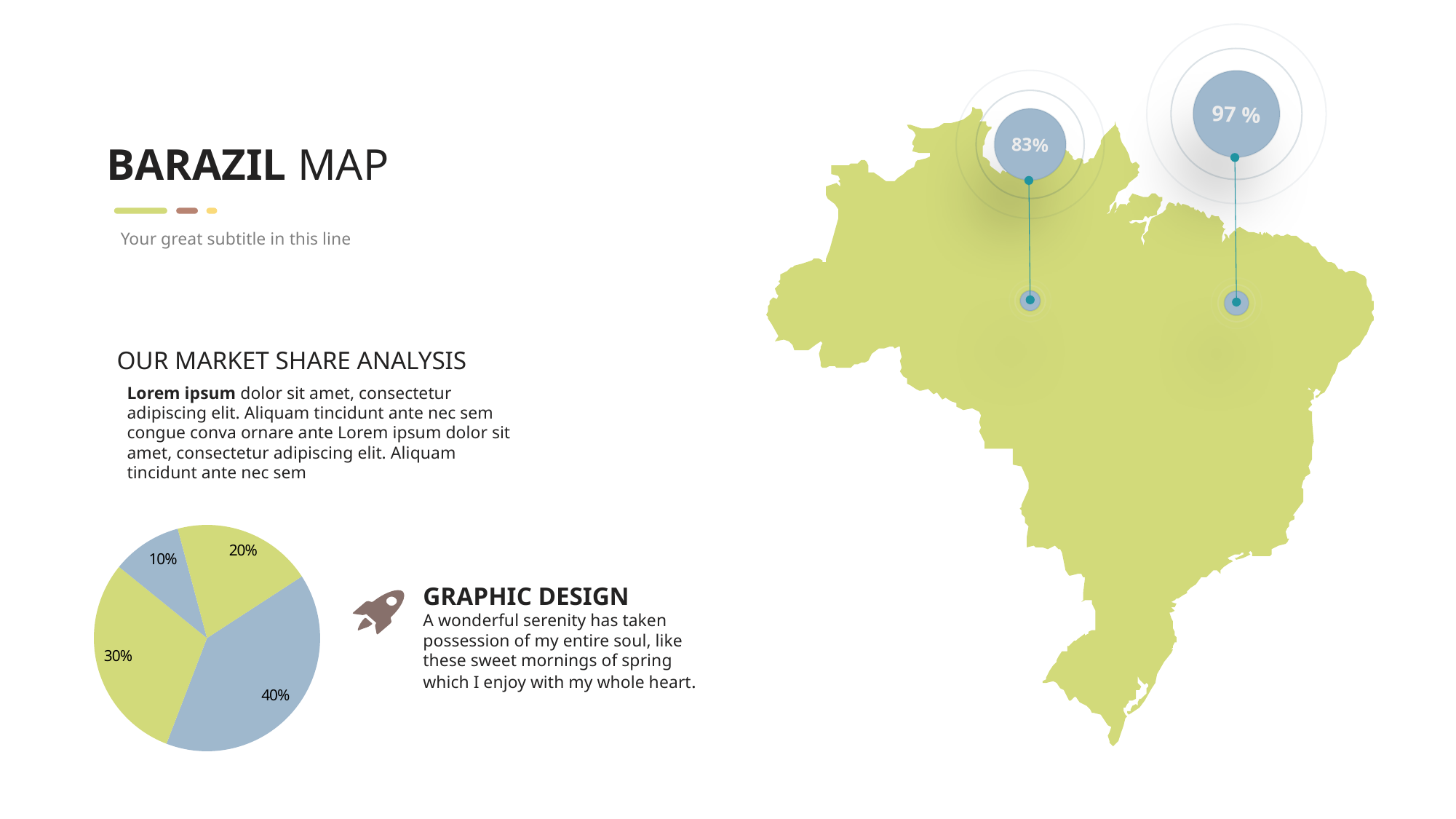
Is the largest slice of the pie chart greater or less than 30%? greater What kind of chart is shown at the bottom left of the slide? pie chart What is the value of the largest slice in the pie chart? 40% What colour is the largest slice of the pie chart? blue Which is larger in the pie chart, the 30% slice or the 20% slice? the 30% slice On the Brazil map, what percentage is shown in the left-hand marker? 83% What is the value of the smallest slice in the pie chart? 10% What do the four slices of the pie chart add up to? 100% On the Brazil map, what percentage is shown in the right-hand marker? 97 % How many slices does the pie chart have? 4 What is the difference between the largest and smallest slices in the pie chart? 30 percentage points How many slices of the pie chart are green? 2